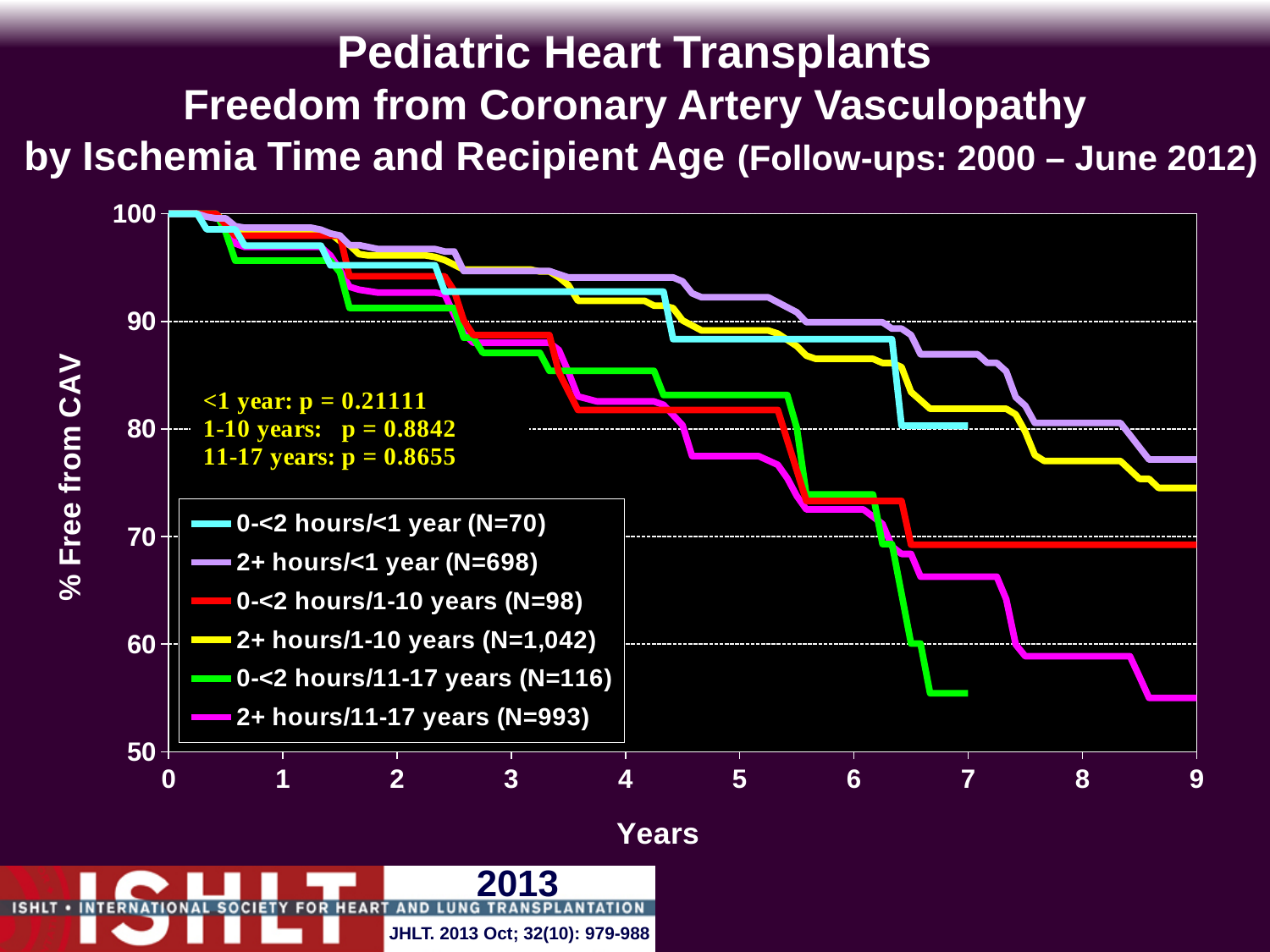
Which series has the lowest % free from CAV at year 9? 2+ hours/11-17 years (N=993) Which series has the highest % free from CAV at year 9? 2+ hours/<1 year (N=698) Is the value for 2+ hours/1-10 years at year 9 greater or less than 80? less What is the % free from CAV for all series at year 0? 100 What is the N for the 2+ hours/1-10 years series in the legend? 1,042 How many series does the legend list? 6 Is the value for 2+ hours/<1 year at year 5 greater or less than 90? greater Do the values for the series rise or fall as the years increase? fall At year 8, which series is higher: 2+ hours/1-10 years or 0-<2 hours/1-10 years? 2+ hours/1-10 years What kind of chart is shown on the slide? line chart Is the value for 2+ hours/11-17 years at year 9 greater or less than 60? less What p-value is shown for the <1 year comparison? 0.21111